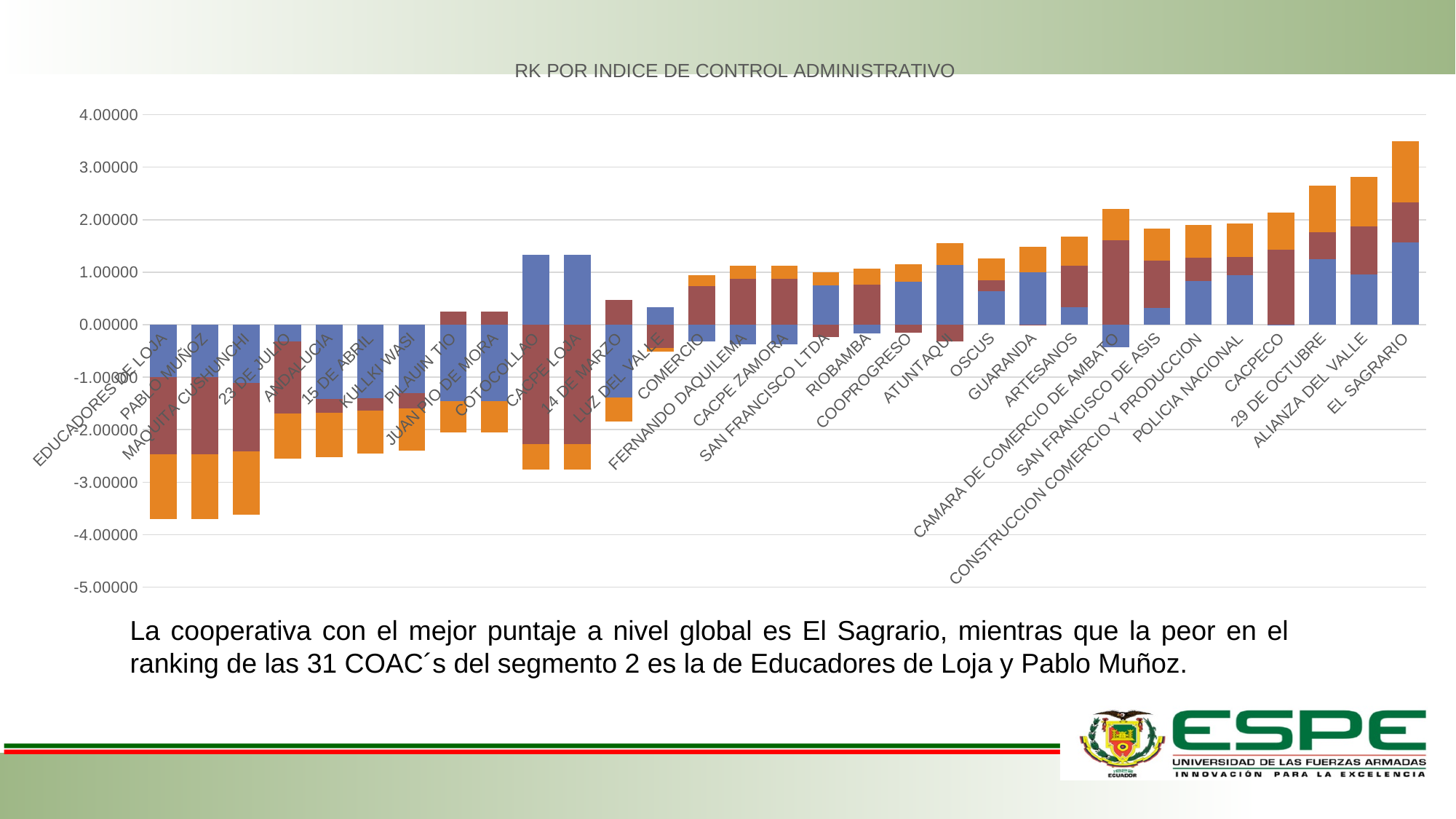
What kind of chart is shown on the slide? Stacked bar chart What is the title of the chart? RK POR INDICE DE CONTROL ADMINISTRATIVO What is the lowest value shown on the vertical axis of the chart? -5.00000 Is the top of the stacked bar for ALIANZA DEL VALLE greater or less than 3.00000? less Which has the higher stacked bar top, EL SAGRARIO or ALIANZA DEL VALLE? EL SAGRARIO How many cooperatives (categories) are plotted on the x axis of the chart? 31 Is the top of the stacked bar for EL SAGRARIO greater or less than 3.00000? greater Do the stacked bar values generally rise or fall moving from left to right along the x axis? rise Is the top of the stacked bar for CACPECO greater or less than 2.00000? greater How many differently coloured segments make up each stacked bar in the chart? 3 Which cooperative has the tallest positive stacked bar in the chart? EL SAGRARIO